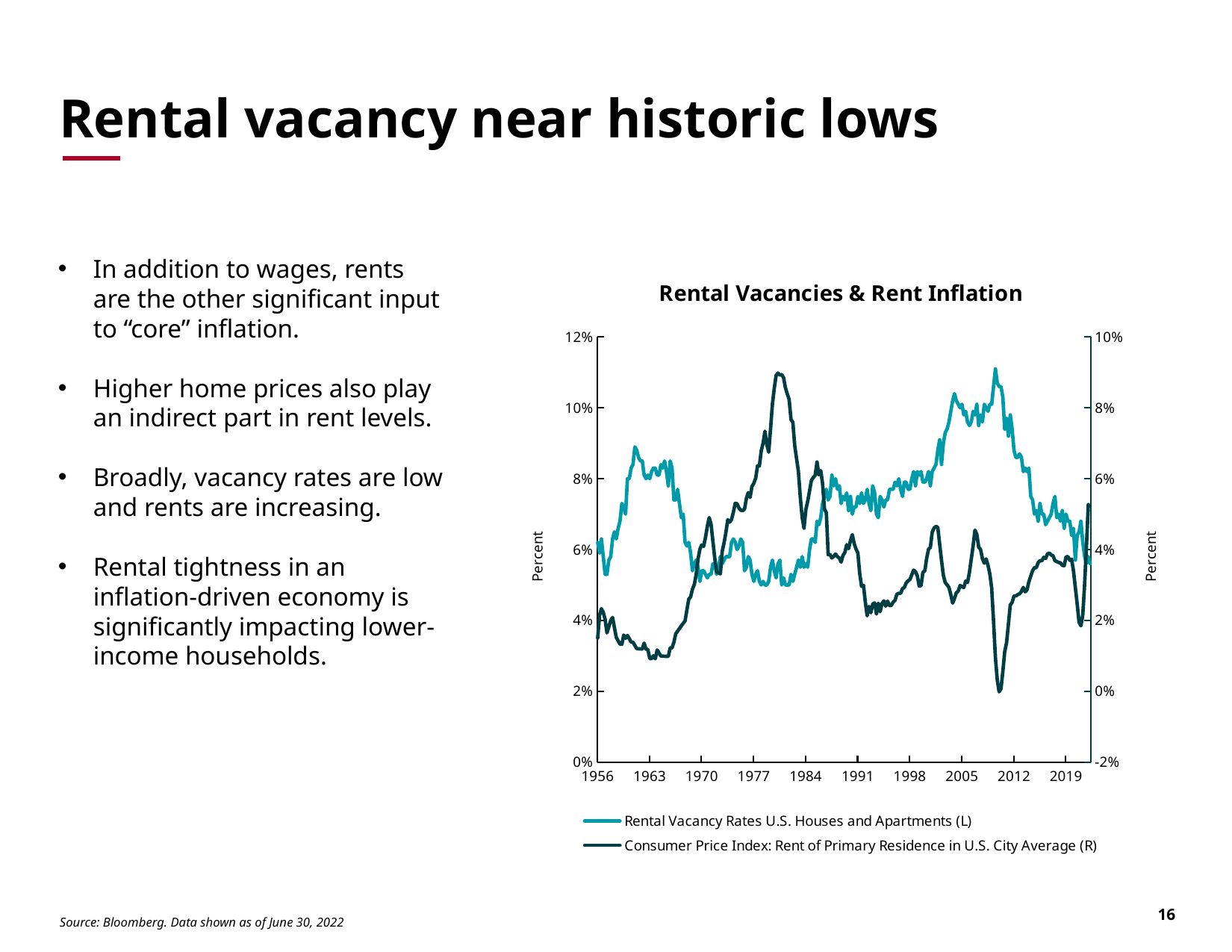
Is the peak value of the Consumer Price Index: Rent of Primary Residence series around 1980 greater or less than 8% on the right axis? greater What kind of chart is shown on the slide? Line chart Does the Consumer Price Index: Rent of Primary Residence series rise or fall between 1970 and 1980? rise Does the Rental Vacancy Rates series rise or fall between 2009 and 2019? fall Is the peak value of the Rental Vacancy Rates series around 2009 greater or less than 10% on the left axis? greater Is the Rental Vacancy Rates series higher around 2009 or around 2019? around 2009 How many series does the legend list? 2 Is the lowest value of the Consumer Price Index: Rent of Primary Residence series around 2010 greater or less than 2% on the right axis? less What is the title of the chart? Rental Vacancies & Rent Inflation Which series is plotted on the right axis according to the legend? Consumer Price Index: Rent of Primary Residence in U.S. City Average (R) Is the Consumer Price Index: Rent of Primary Residence series higher around 1980 or around 2010? around 1980